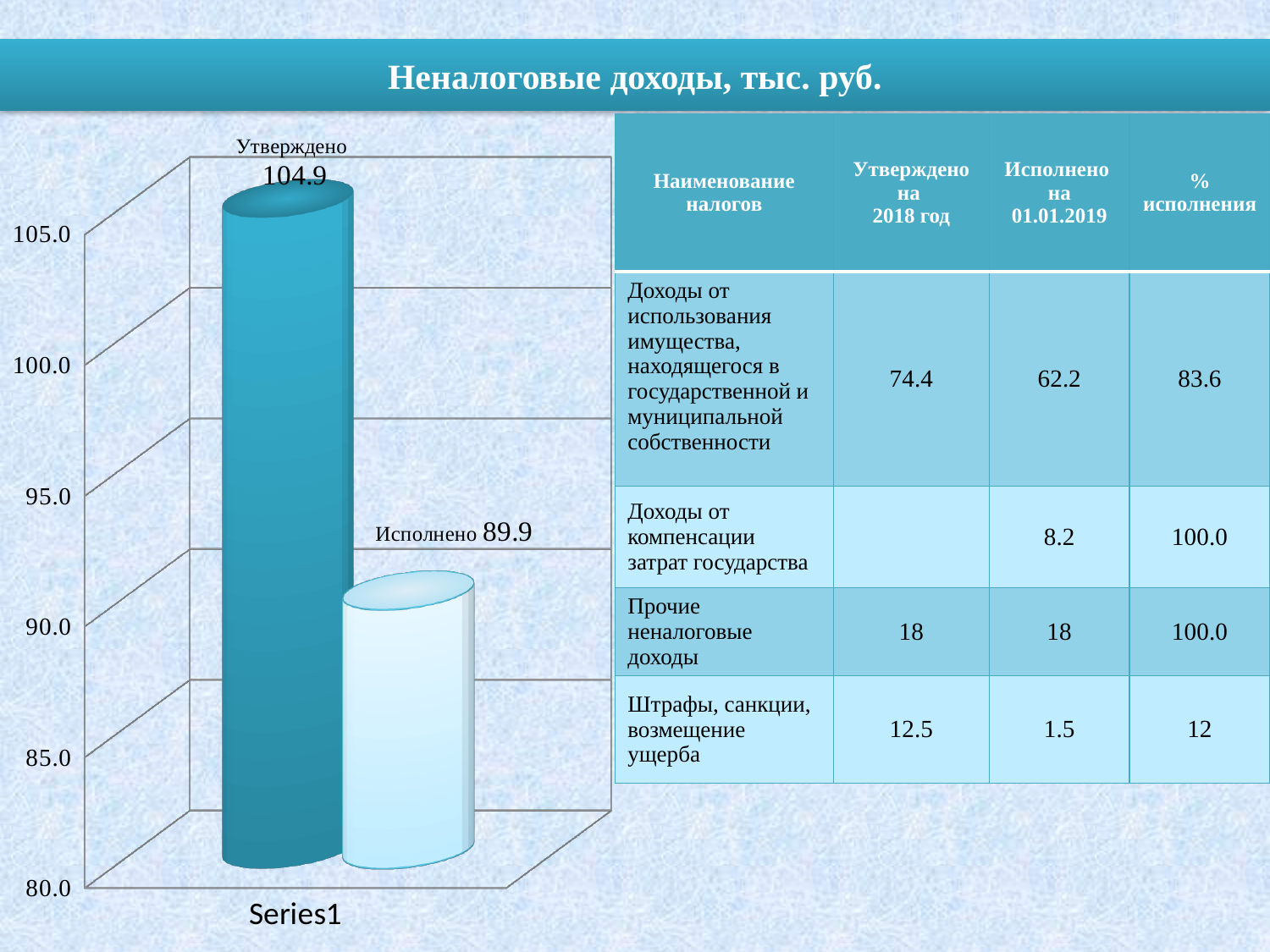
What is the lowest value shown on the vertical axis of the chart? 80.0 What is the difference between the Утверждено and Исполнено values? 15.0 What is the value of the Утверждено bar? 104.9 Is the value for Утверждено greater or less than 100.0? greater Which bar is higher, Утверждено or Исполнено? Утверждено Which bar has the lowest value? Исполнено What kind of chart is shown on the slide? bar chart How many bars are plotted in the chart? 2 What is the title of the slide above the chart? Неналоговые доходы, тыс. руб. What is the value of the Исполнено bar? 89.9 Is the value for Исполнено greater or less than 90.0? less